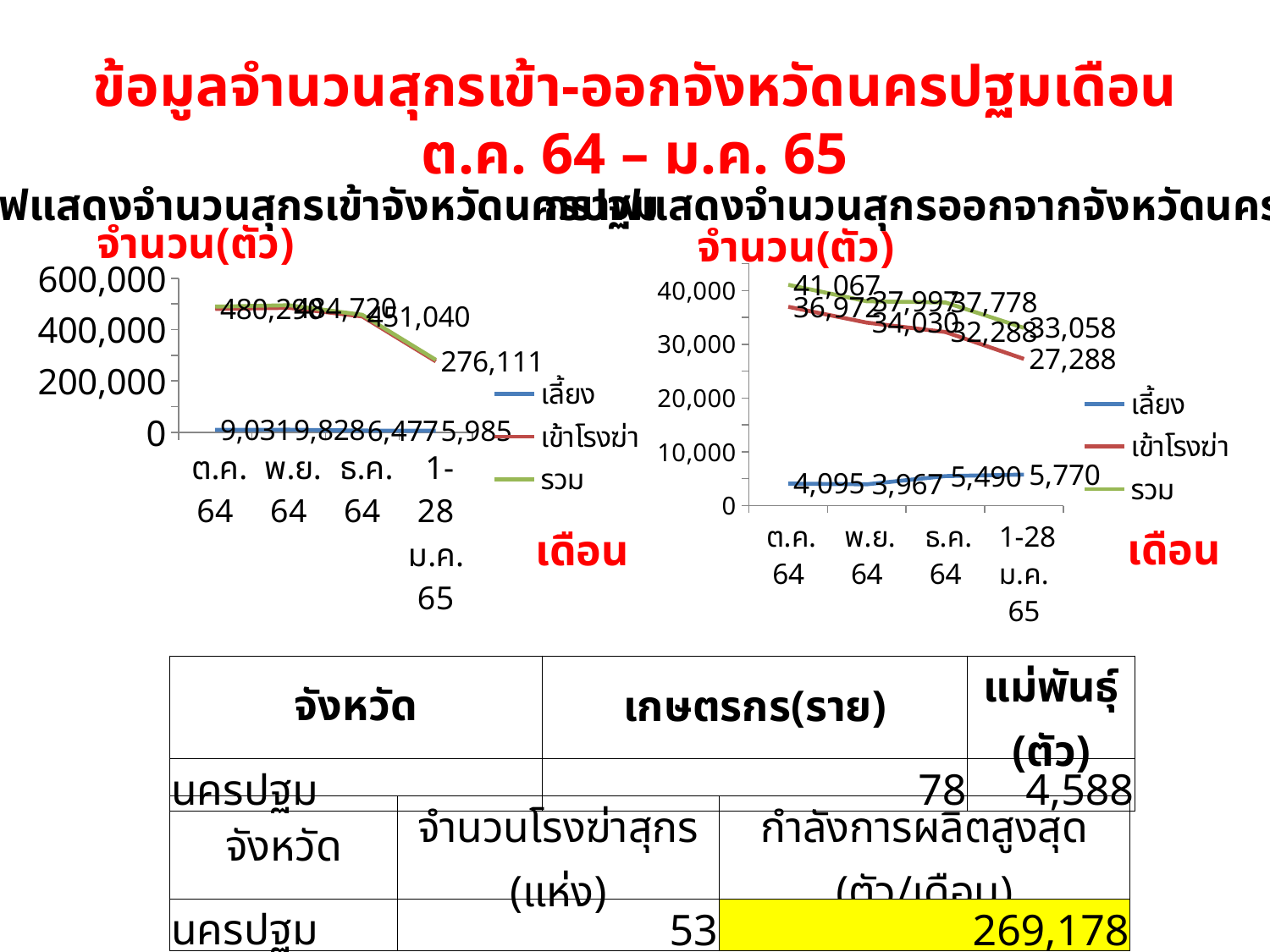
In the right chart, which month has the lowest value for รวม? 1-28 ม.ค. 65 What kind of chart is the left chart? line chart In the left chart, what is the value of เลี้ยง for ต.ค. 64? 9,031 In the left chart, which month has the highest value for เลี้ยง? พ.ย. 64 In the left chart, is the value of รวม for 1-28 ม.ค. 65 greater or less than 400,000? less In the right chart, what is the difference between the รวม values for ต.ค. 64 and 1-28 ม.ค. 65? 8,009 In the right chart, what is the value of เข้าโรงฆ่า for 1-28 ม.ค. 65? 27,288 How many series does the legend of the right chart list? 3 In the right chart, what is the value of รวม for ต.ค. 64? 41,067 In the left chart, what is the difference between the เลี้ยง values for พ.ย. 64 and ต.ค. 64? 797 In the left chart, what is the value of เลี้ยง for 1-28 ม.ค. 65? 5,985 In the right chart, does the เข้าโรงฆ่า series rise or fall from ต.ค. 64 to 1-28 ม.ค. 65? fall